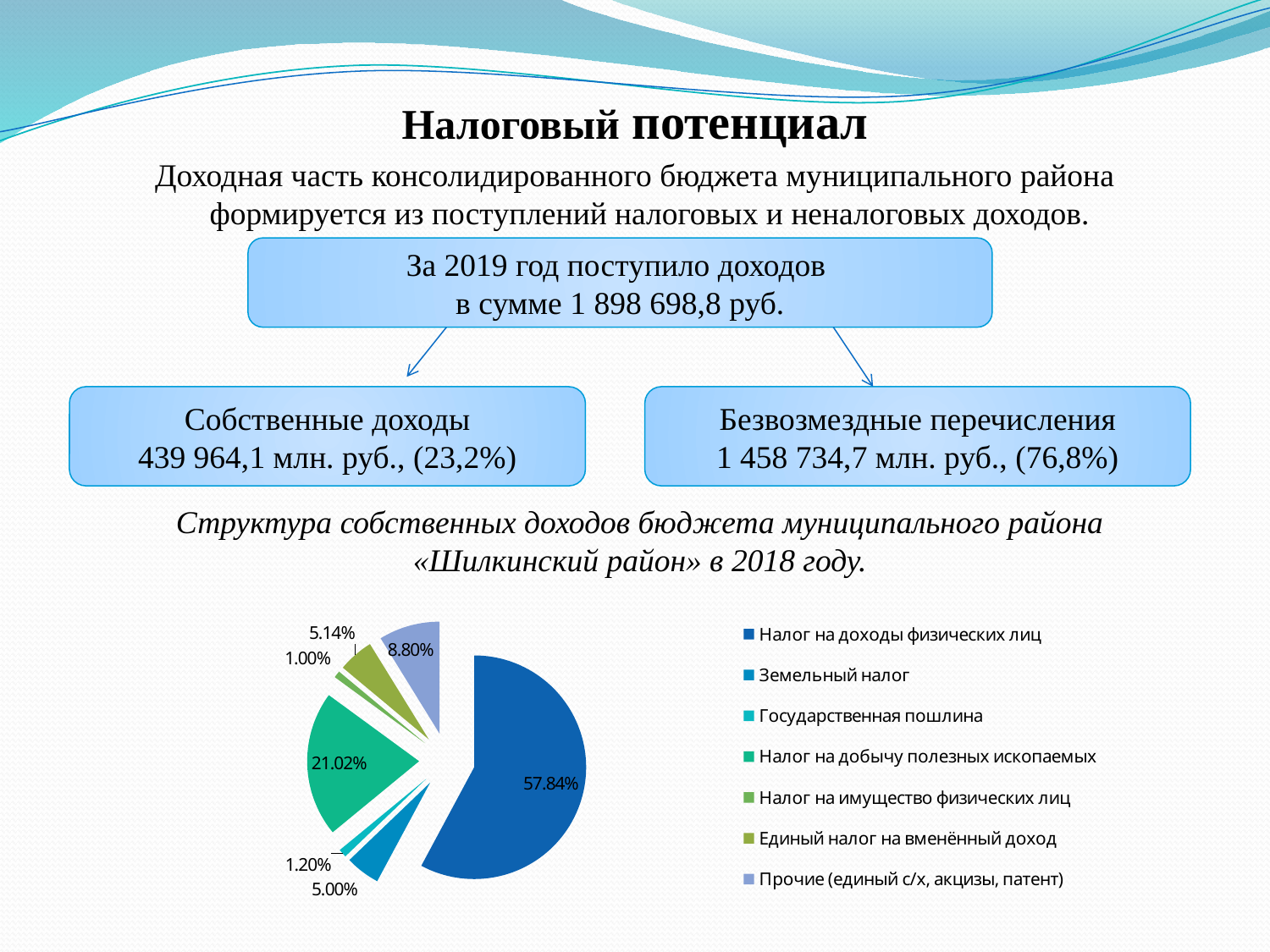
Which category has the largest slice of the pie? Налог на доходы физических лиц What is the value shown for Земельный налог? 5.00% What is the value shown for Прочие (единый с/х, акцизы, патент)? 8.80% Which is larger: the share of Прочие (единый с/х, акцизы, патент) or the share of Земельный налог? Прочие (единый с/х, акцизы, патент) What is the difference between the shares of Налог на доходы физических лиц and Налог на добычу полезных ископаемых? 36.82% How many categories does the pie chart legend list? 7 What colour is the slice for Налог на добычу полезных ископаемых? green What kind of chart is shown on the slide? pie chart What share of the pie does Налог на доходы физических лиц have? 57.84% What is the value shown for Единый налог на вменённый доход? 5.14% Which category has the smallest slice of the pie? Налог на имущество физических лиц What share of the pie does Налог на добычу полезных ископаемых have? 21.02%